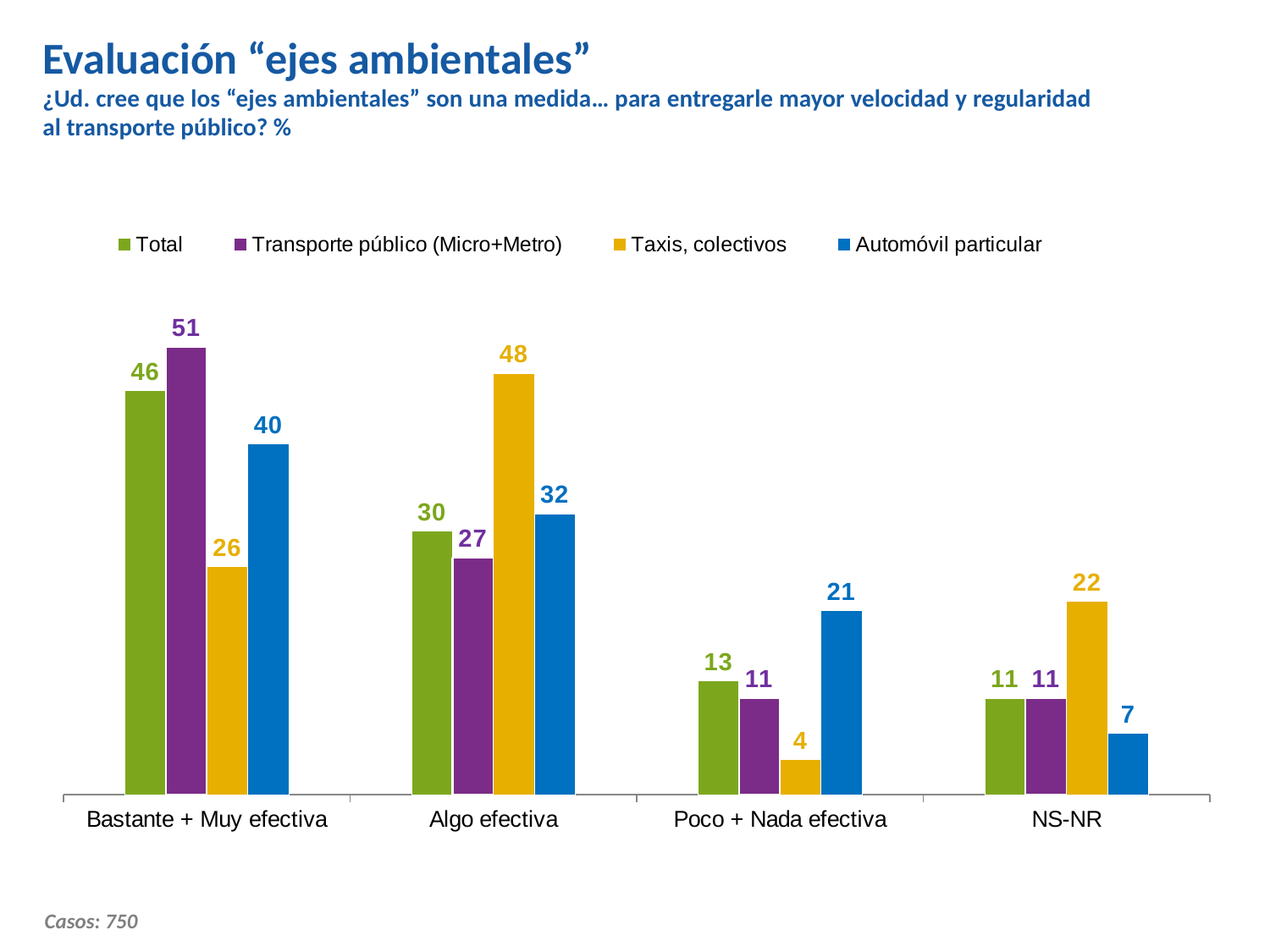
Which series has the lowest value in the Poco + Nada efectiva category? Taxis, colectivos What is the value for Automóvil particular in the Poco + Nada efectiva category? 21 Which is larger in the Bastante + Muy efectiva category: the Total value or the Automóvil particular value? Total How many categories are shown on the x axis? 4 What is the value for Taxis, colectivos in the Algo efectiva category? 48 What is the Total value for NS-NR? 11 What is the difference between the Taxis, colectivos value and the Transporte público (Micro+Metro) value in the Algo efectiva category? 21 What colour represents the Taxis, colectivos series? Yellow Which series has the highest value in the Bastante + Muy efectiva category? Transporte público (Micro+Metro) What is the value for Transporte público (Micro+Metro) in the Bastante + Muy efectiva category? 51 What kind of chart is shown on the slide? Bar chart How many series does the legend list? 4